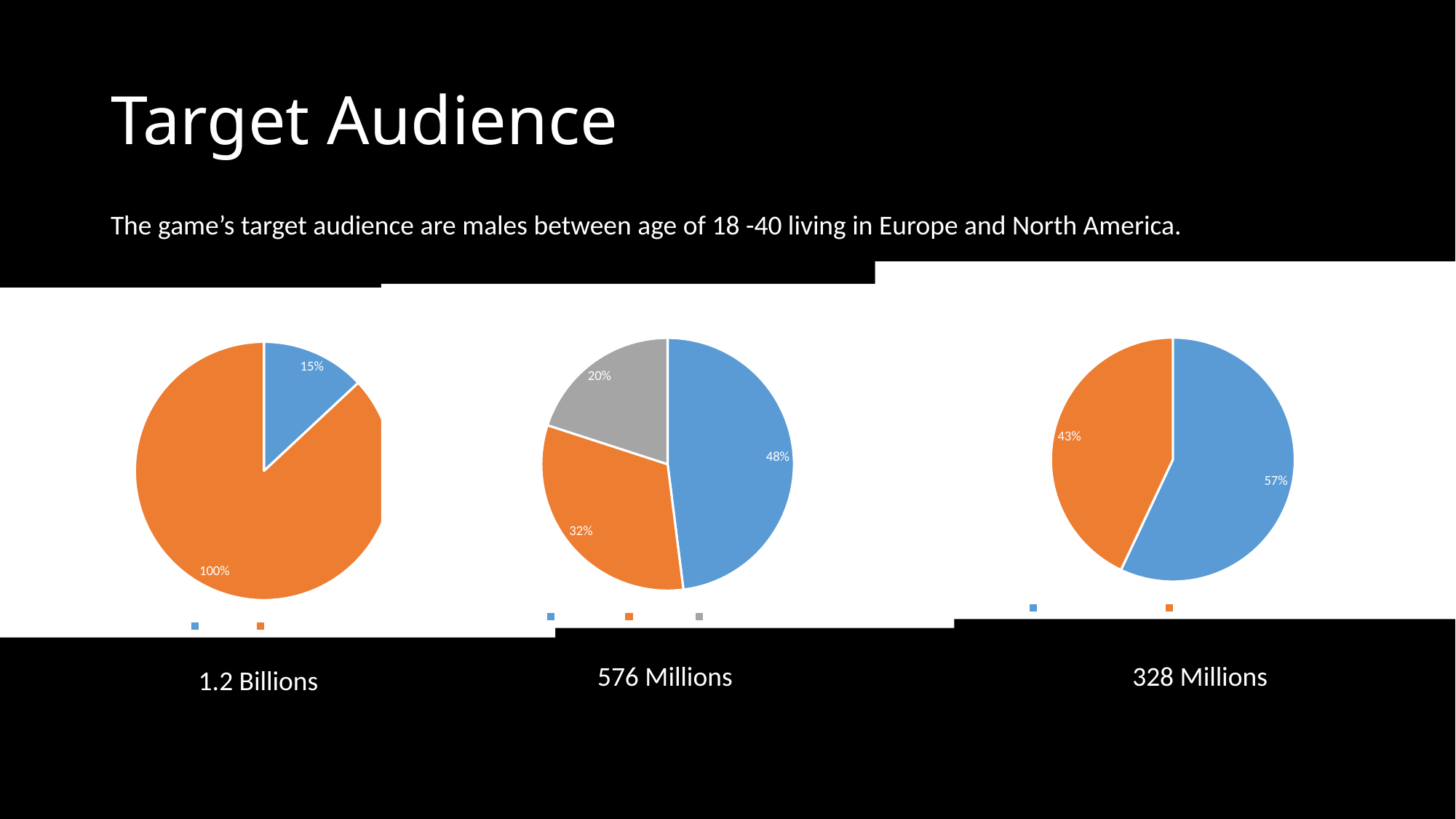
In the right pie chart labelled 328 Millions, which colour slice is the largest? blue How many slices does the right pie chart labelled 328 Millions have? 2 In the right pie chart labelled 328 Millions, what is the difference in percentage points between the blue slice and the orange slice? 14 In the right pie chart labelled 328 Millions, what percentage is shown on the orange slice? 43% In the middle pie chart labelled 576 Millions, what percentage is shown on the orange slice? 32% How many slices does the middle pie chart labelled 576 Millions have? 3 What kind of chart is the left chart labelled 1.2 Billions? pie chart In the middle pie chart labelled 576 Millions, what percentage is shown on the grey slice? 20% How many pie charts are shown on the slide? 3 In the left pie chart labelled 1.2 Billions, what percentage is shown on the blue slice? 15% In the middle pie chart labelled 576 Millions, what percentage is shown on the blue slice? 48% In the middle pie chart labelled 576 Millions, which colour slice is the smallest? grey